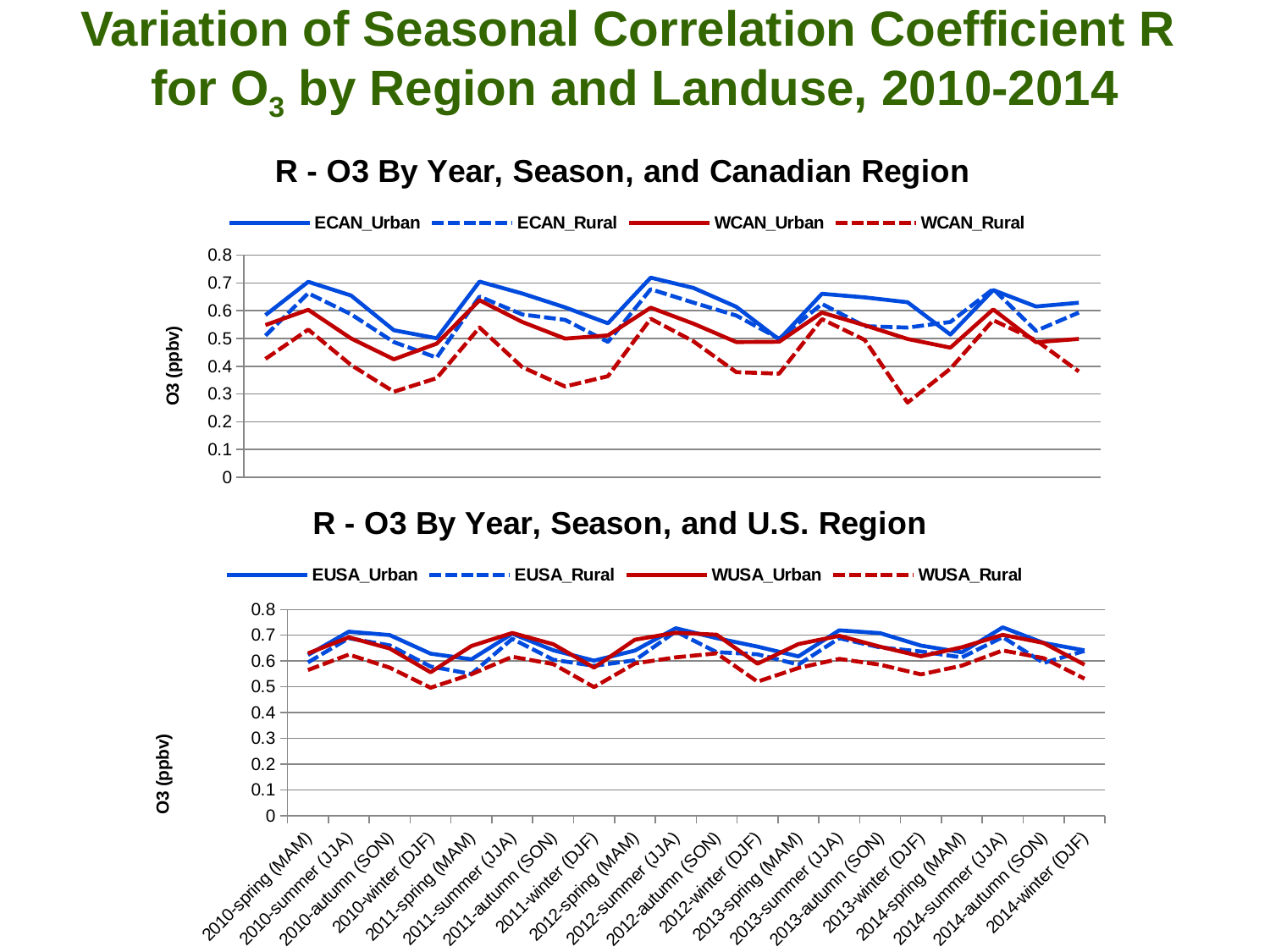
In the 'R - O3 By Year, Season, and Canadian Region' chart, which series has the lowest values overall? WCAN_Rural In the 'R - O3 By Year, Season, and U.S. Region' chart, is the value for EUSA_Urban at 2012-summer (JJA) greater or less than 0.6? greater In the 'R - O3 By Year, Season, and U.S. Region' chart, is the value for EUSA_Urban at 2010-summer (JJA) greater or less than 0.6? greater In the 'R - O3 By Year, Season, and Canadian Region' chart, which series reaches the highest value? ECAN_Urban In the 'R - O3 By Year, Season, and Canadian Region' chart, is the lowest value of the WCAN_Rural series greater or less than 0.3? less How many x-axis categories are shown on the 'R - O3 By Year, Season, and U.S. Region' chart? 20 What kind of chart is the 'R - O3 By Year, Season, and Canadian Region' chart? line chart How many series does the legend of the 'R - O3 By Year, Season, and U.S. Region' chart list? 4 What is the y-axis label on the 'R - O3 By Year, Season, and U.S. Region' chart? O3 (ppbv) Which legend entries in the 'R - O3 By Year, Season, and Canadian Region' chart are drawn with dashed lines? ECAN_Rural and WCAN_Rural How many series does the legend of the 'R - O3 By Year, Season, and Canadian Region' chart list? 4